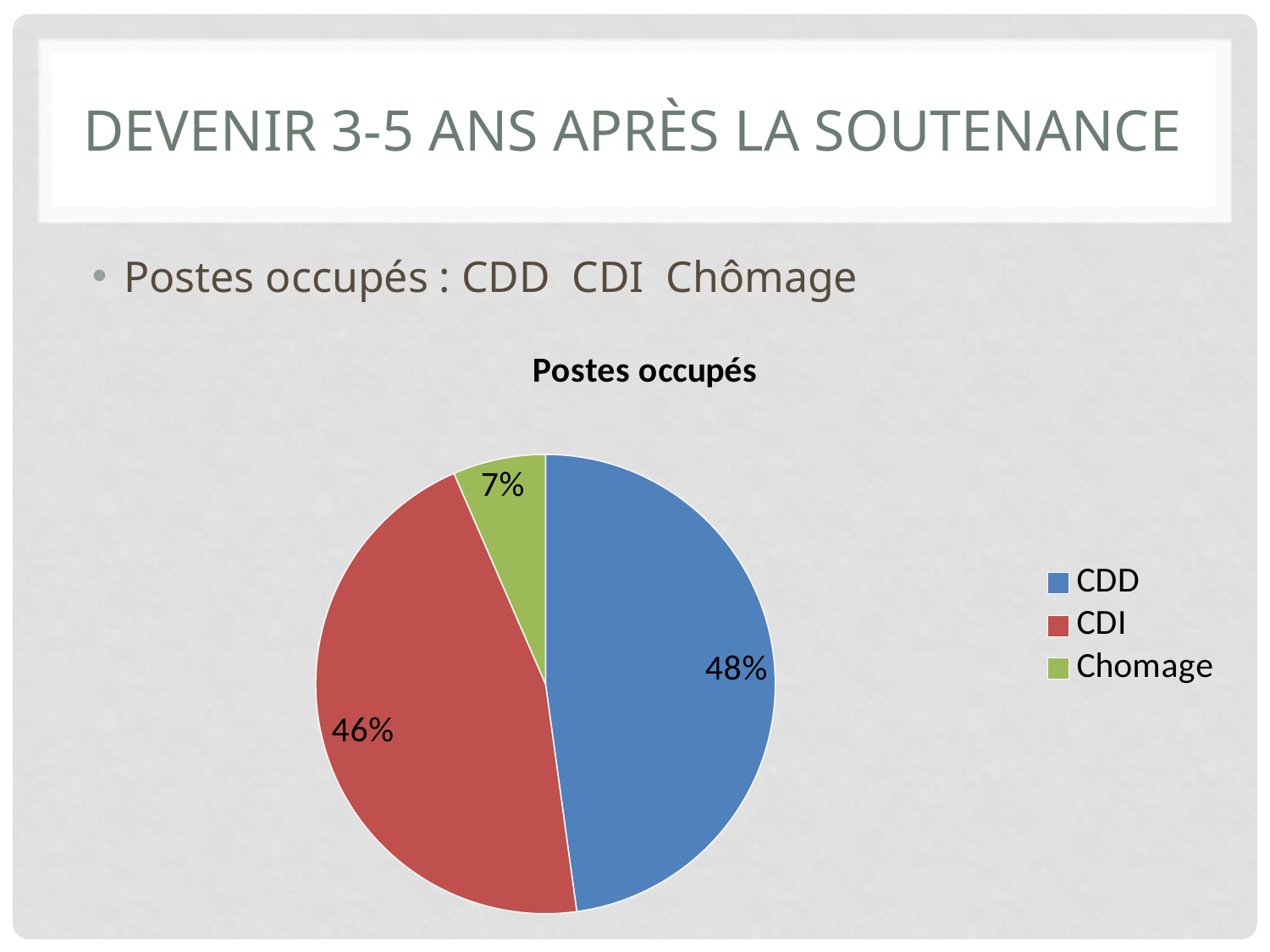
What kind of chart is shown on the slide? pie chart Which category has the largest slice of the pie? CDD Which colour represents CDI in the chart? red What share of the pie does Chomage represent? 7% What is the title of the chart? Postes occupés What is the difference in percentage points between the CDD and CDI slices? 2 What share of the pie does CDI represent? 46% What is the difference in percentage points between the CDI and Chomage slices? 39 What share of the pie does CDD represent? 48% Which is larger, the CDI slice or the Chomage slice? CDI Which category has the smallest slice of the pie? Chomage How many categories does the pie chart show? 3